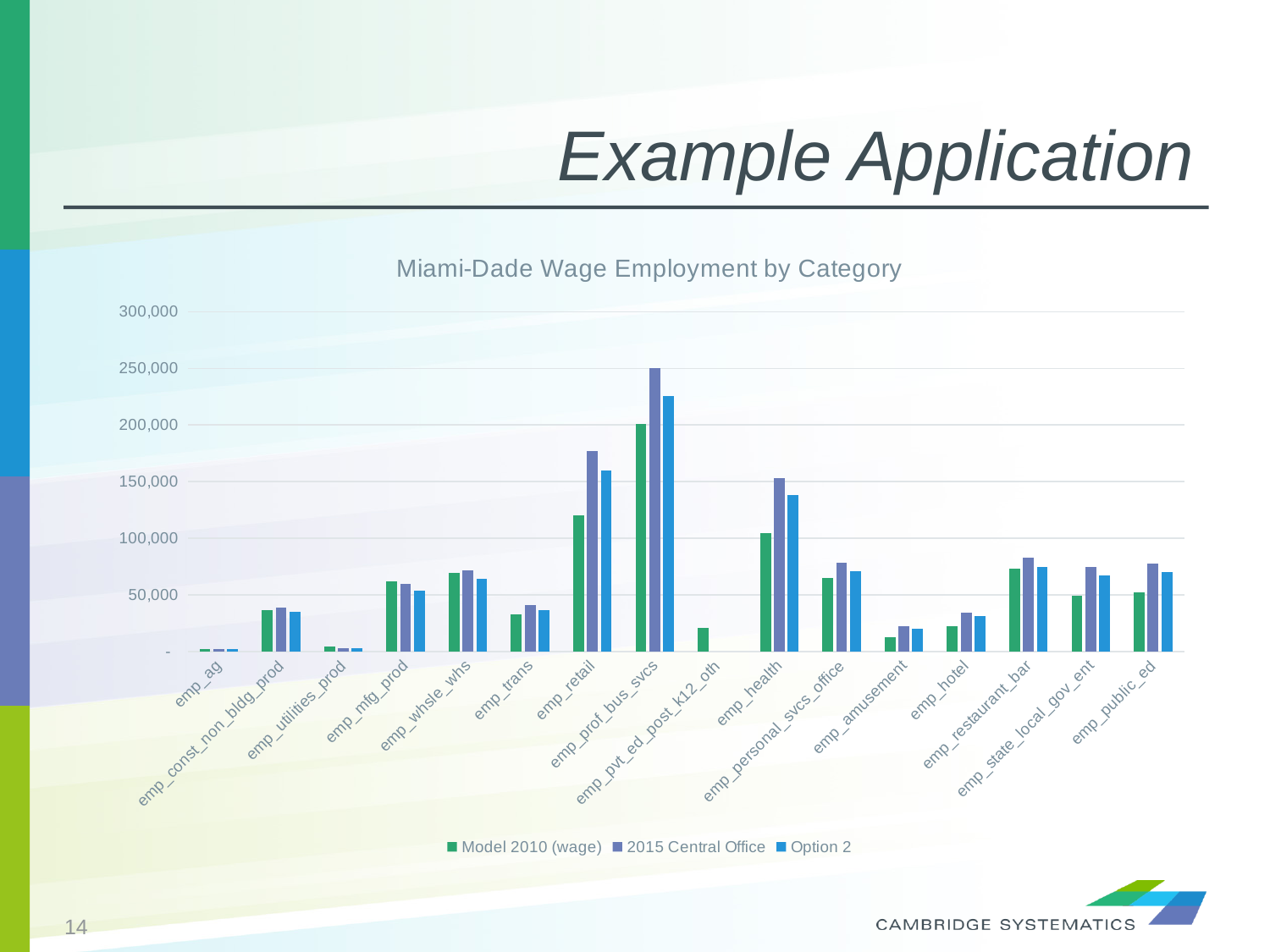
Which series has the highest value for emp_prof_bus_svcs? 2015 Central Office Is the Option 2 value for emp_prof_bus_svcs greater or less than 200,000? greater For the 2015 Central Office series, which is larger: emp_retail or emp_health? emp_retail Is the 2015 Central Office value for emp_retail greater or less than 150,000? greater How many series does the legend list? 3 How many employment categories are shown on the x axis? 16 For emp_prof_bus_svcs, which is larger: the 2015 Central Office value or the Option 2 value? 2015 Central Office Which category has the tallest bar in the chart? emp_prof_bus_svcs What type of chart is shown on the slide? Bar chart Which category has the lowest values across all series? emp_ag Is the Model 2010 (wage) value for emp_trans greater or less than 50,000? less What is the title of the chart? Miami-Dade Wage Employment by Category